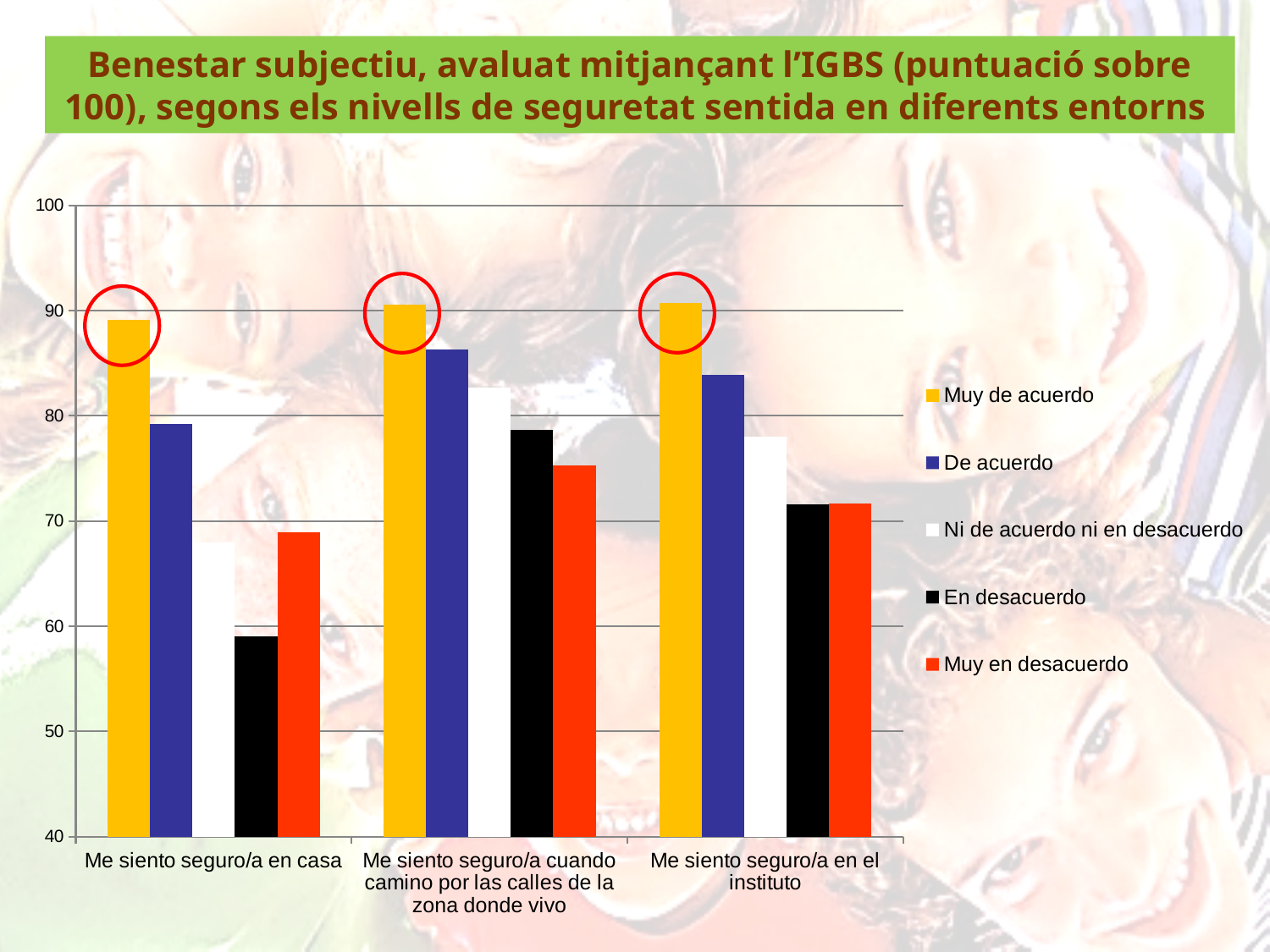
Which series has the highest value in 'Me siento seguro/a en casa'? Muy de acuerdo Is the value for 'Muy en desacuerdo' in 'Me siento seguro/a cuando camino por las calles de la zona donde vivo' greater or less than 70? greater Is the value for 'Ni de acuerdo ni en desacuerdo' in 'Me siento seguro/a en el instituto' greater or less than 70? greater What colour represents 'Muy de acuerdo' in the legend? yellow Which series' bars are circled in red on the chart? Muy de acuerdo Is the value for 'En desacuerdo' in 'Me siento seguro/a en casa' greater or less than 60? less Which is larger: 'De acuerdo' in 'Me siento seguro/a en casa' or 'De acuerdo' in 'Me siento seguro/a cuando camino por las calles de la zona donde vivo'? Me siento seguro/a cuando camino por las calles de la zona donde vivo What kind of chart is shown on the slide? bar chart Which series has the lowest value in 'Me siento seguro/a en casa'? En desacuerdo How many categories are shown on the x axis? 3 How many series does the legend list? 5